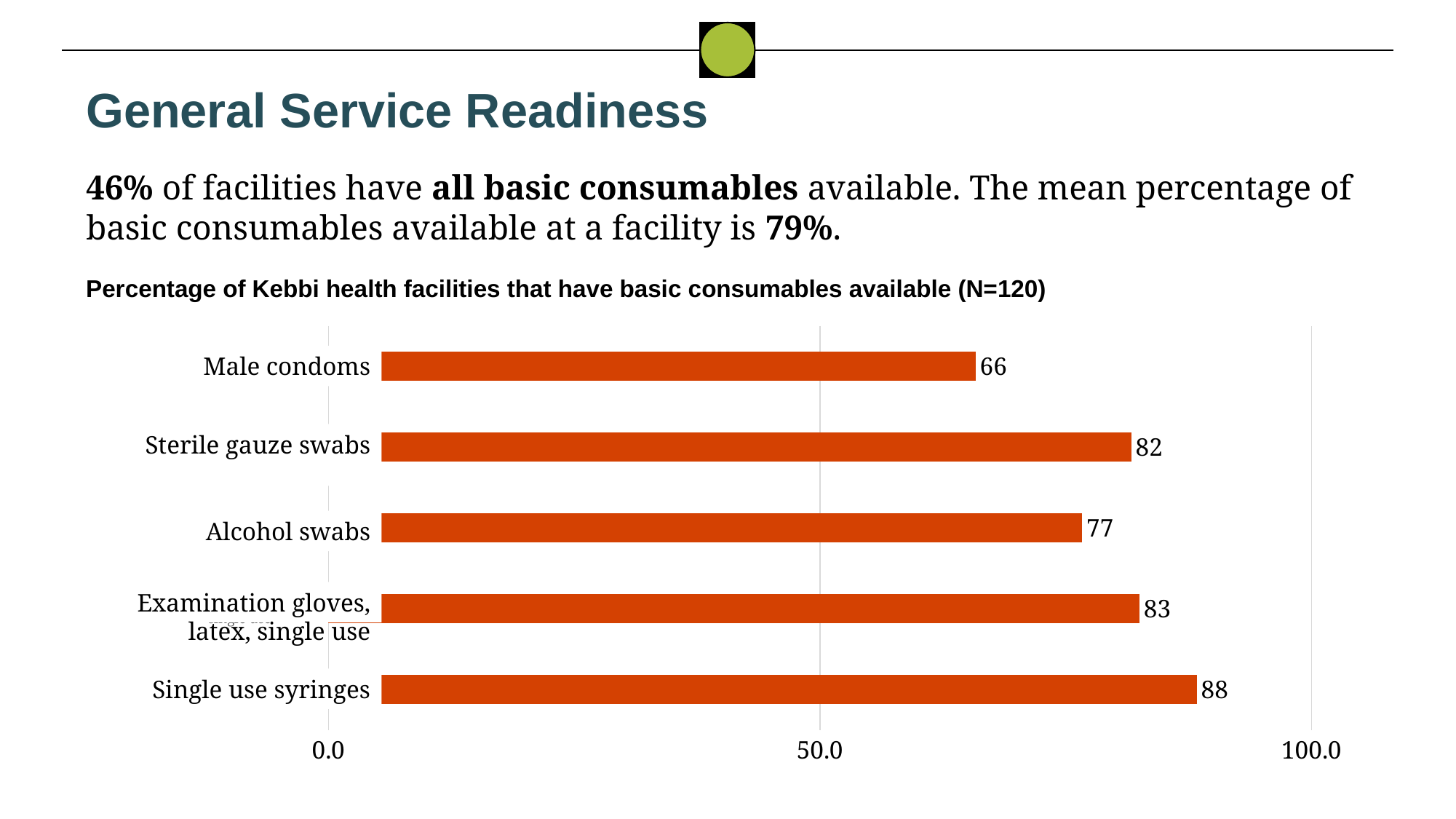
What is the value for Male condoms? 66 How many categories are shown in the chart? 5 Which is larger, the value for Alcohol swabs or the value for Sterile gauze swabs? Sterile gauze swabs Is the value for Male condoms greater or less than 50.0? greater What is the difference between the values for Single use syringes and Male condoms? 22 What is the value for Alcohol swabs? 77 Which category has the highest value? Single use syringes What is the title of the chart? Percentage of Kebbi health facilities that have basic consumables available (N=120) What is the value for Sterile gauze swabs? 82 What is the value for Examination gloves, latex, single use? 83 What kind of chart is shown on the slide? bar chart Which category has the lowest value? Male condoms